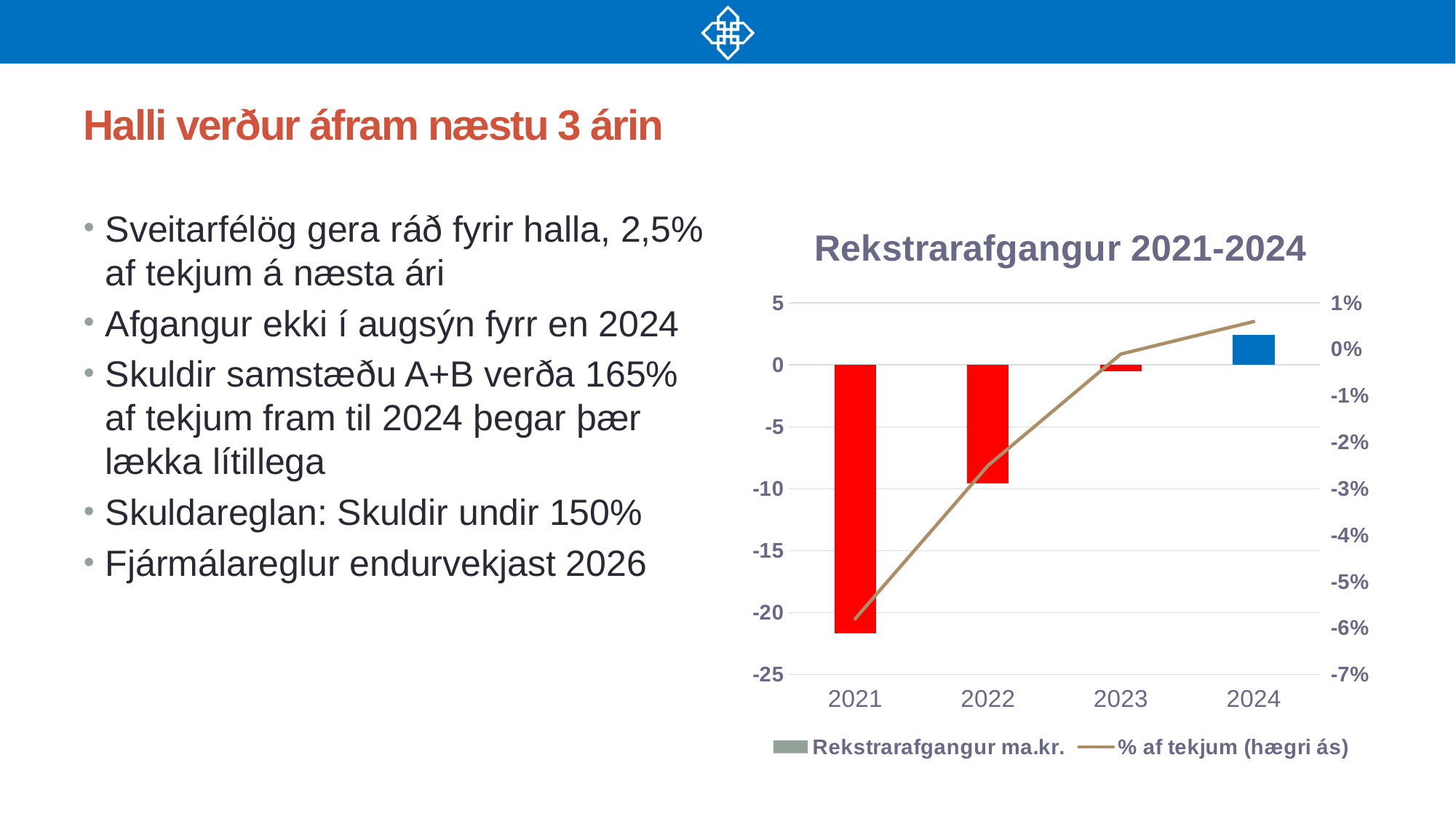
Which year has the lowest Rekstrarafgangur ma.kr. bar? 2021 What are the two series named in the chart legend? Rekstrarafgangur ma.kr. and % af tekjum (hægri ás) What kind of chart is shown on the slide? A bar chart combined with a line Is the Rekstrarafgangur ma.kr. value for 2022 greater or less than -5? less How many years are shown on the x axis of the chart? 4 How many series does the chart legend list? 2 Do the Rekstrarafgangur ma.kr. values rise or fall from 2021 to 2024? rise Is the Rekstrarafgangur ma.kr. value for 2024 greater or less than 0? greater Is the Rekstrarafgangur ma.kr. value for 2021 greater or less than -20? less What is the title of the chart? Rekstrarafgangur 2021-2024 Which year has the highest Rekstrarafgangur ma.kr. bar? 2024